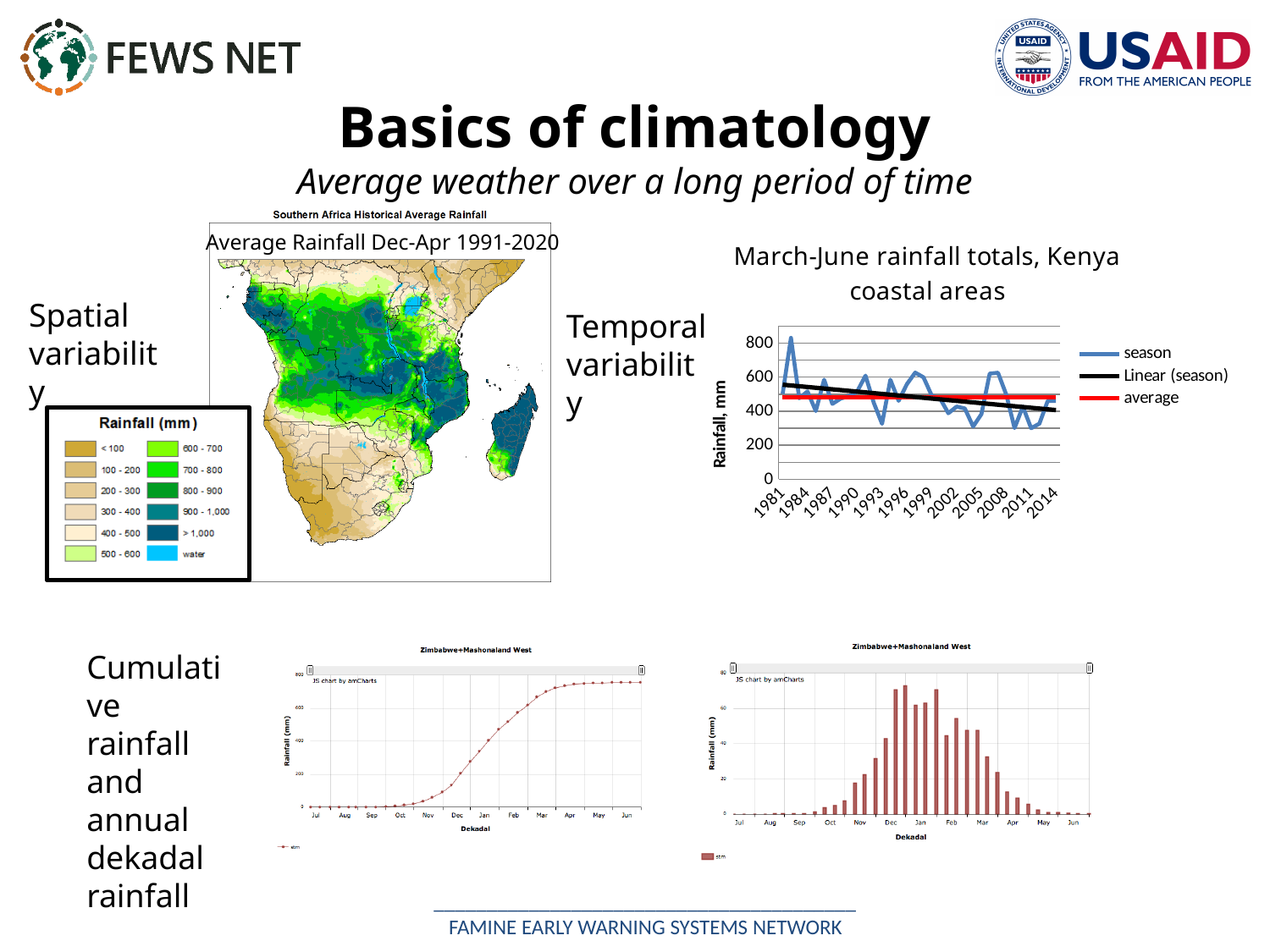
In the 'March-June rainfall totals, Kenya coastal areas' chart, what is the label of the y axis? Rainfall, mm How many series does the legend of the 'March-June rainfall totals, Kenya coastal areas' chart list? 3 What kind of chart is the bottom-left 'Zimbabwe+Mashonaland West' chart? line chart In the 'March-June rainfall totals, Kenya coastal areas' chart, what is the first year shown on the x axis? 1981 In the bottom-right 'Zimbabwe+Mashonaland West' chart, is the tallest bar greater or less than 60? greater What kind of chart is the bottom-right 'Zimbabwe+Mashonaland West' chart? bar chart In the bottom-left 'Zimbabwe+Mashonaland West' chart, do the values rise or fall from Jul to Jun? rise In the bottom-left 'Zimbabwe+Mashonaland West' chart, is the value at Jun greater or less than 600? greater In the 'March-June rainfall totals, Kenya coastal areas' chart, does the 'Linear (season)' trend line rise or fall from 1981 to 2014? fall In the 'March-June rainfall totals, Kenya coastal areas' chart, is the 'average' line greater or less than 600? less What kind of chart is the 'March-June rainfall totals, Kenya coastal areas' chart? line chart